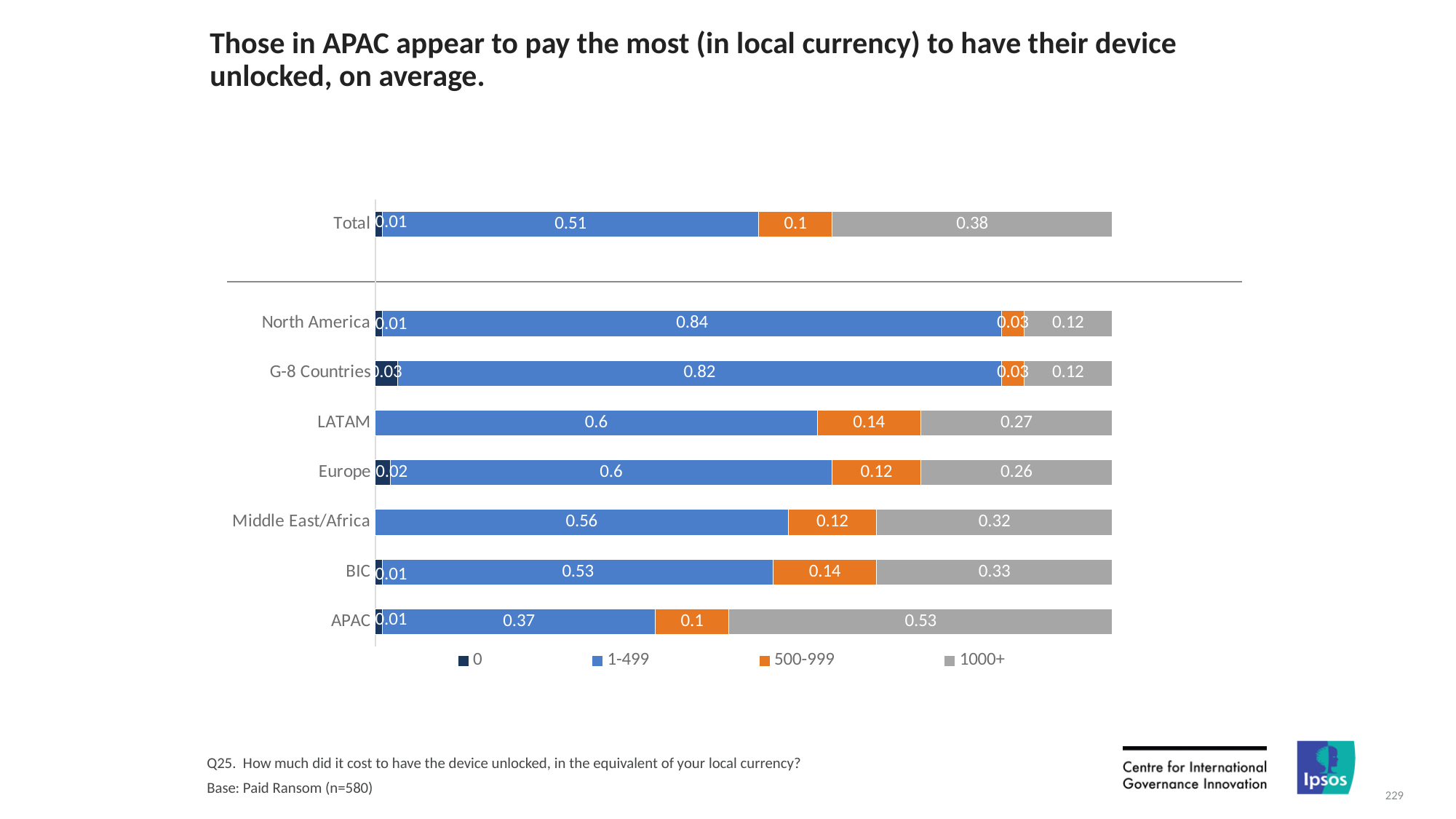
Which is larger, the 1000+ value for Middle East/Africa or for Europe? Middle East/Africa Which region has the highest value for the 1000+ segment? APAC What is the value of the 1-499 segment for North America? 0.84 What is the value of the 500-999 segment for LATAM? 0.14 What is the difference between the 1-499 values for North America and APAC? 0.47 How many series does the legend list? 4 What kind of chart is shown on the slide? Stacked bar chart What is the value of the 1000+ segment for APAC? 0.53 What is the value of the 1000+ segment for Total? 0.38 What is the value of the 0 segment for G-8 Countries? 0.03 How many categories (regions including Total) are plotted on the chart? 8 Which region has the lowest value for the 1-499 segment? APAC